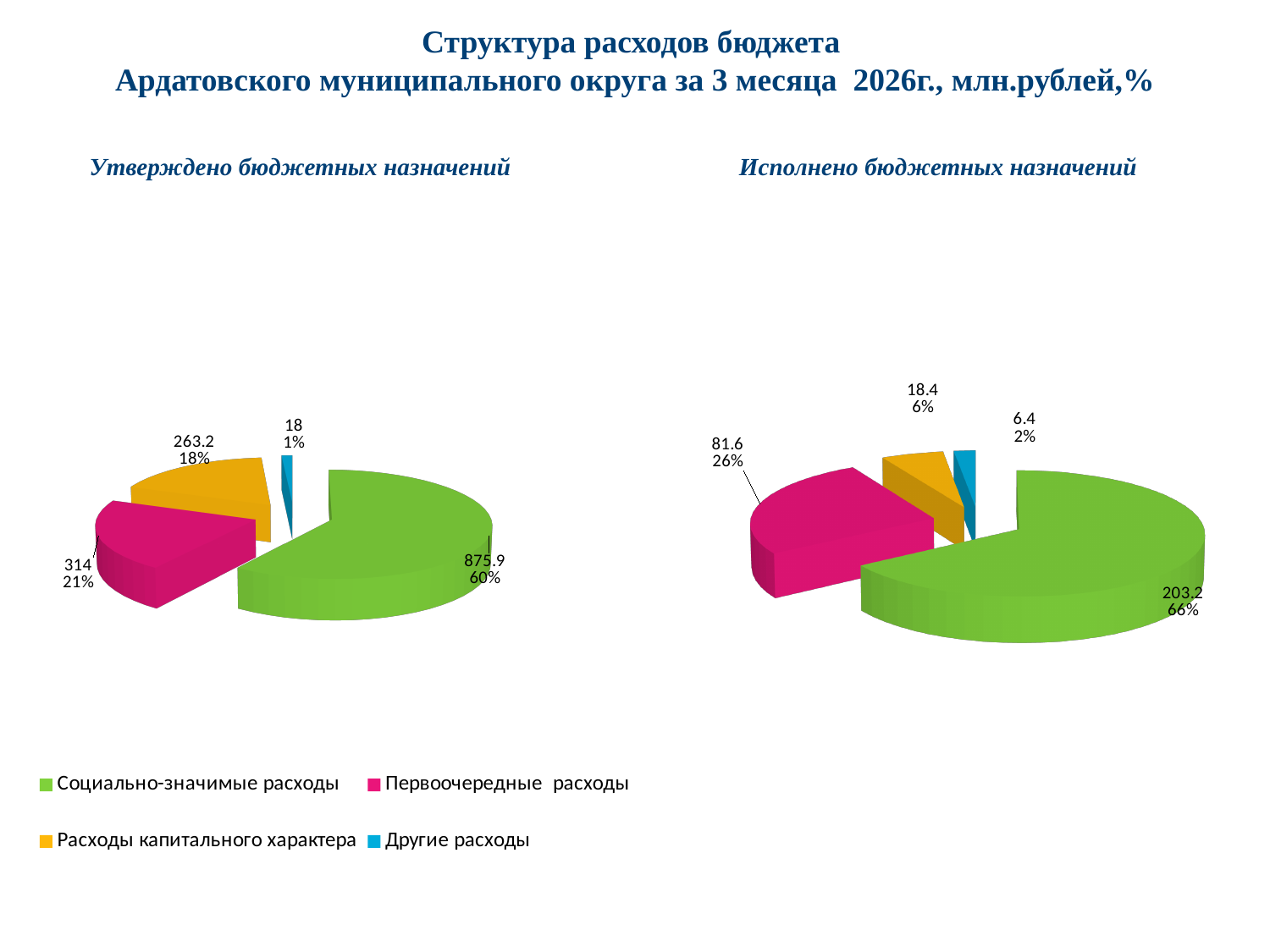
In the 'Исполнено бюджетных назначений' chart, which is larger: Расходы капитального характера or Другие расходы? Расходы капитального характера In the 'Утверждено бюджетных назначений' chart, what share of the pie is Первоочередные расходы? 21% In the 'Исполнено бюджетных назначений' chart, which category has the largest slice? Социально-значимые расходы What kind of chart is the 'Утверждено бюджетных назначений' chart? pie chart In the 'Утверждено бюджетных назначений' chart, which category has the smallest slice? Другие расходы How many slices does the 'Исполнено бюджетных назначений' pie chart have? 4 In the 'Исполнено бюджетных назначений' chart, what is the difference between Расходы капитального характера and Другие расходы? 12 In the 'Утверждено бюджетных назначений' chart, what is the difference between Первоочередные расходы and Расходы капитального характера? 50.8 Which colour represents Расходы капитального характера in the legend? yellow In the 'Утверждено бюджетных назначений' chart, what is the value for Социально-значимые расходы? 875.9 In the 'Исполнено бюджетных назначений' chart, what is the value for Первоочередные расходы? 81.6 In the 'Исполнено бюджетных назначений' chart, what share of the pie is Социально-значимые расходы? 66%